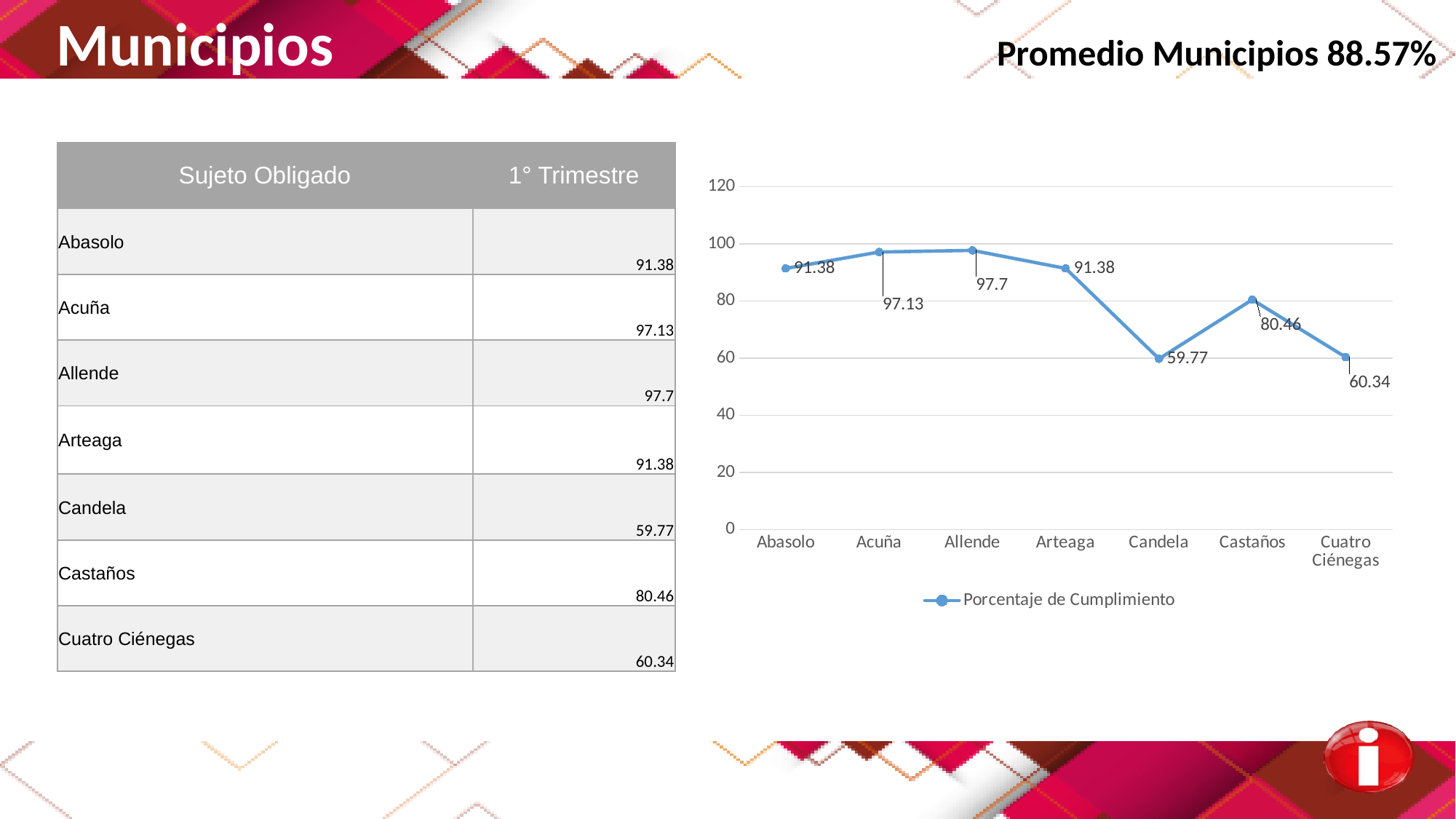
How many municipalities are plotted on the x axis of the chart? 7 What is the value for Castaños in the chart? 80.46 Which municipality has the highest value in the chart? Allende What is the name of the series shown in the chart legend? Porcentaje de Cumplimiento What is the difference between the values for Allende and Cuatro Ciénegas? 37.36 How many series does the chart legend list? 1 Which is larger, the value for Castaños or the value for Cuatro Ciénegas? Castaños What is the value for Acuña in the chart? 97.13 What is the value for Candela in the chart? 59.77 Is the value for Arteaga greater or less than 80? greater Which municipality has the lowest value in the chart? Candela What kind of chart is shown on the slide? line chart